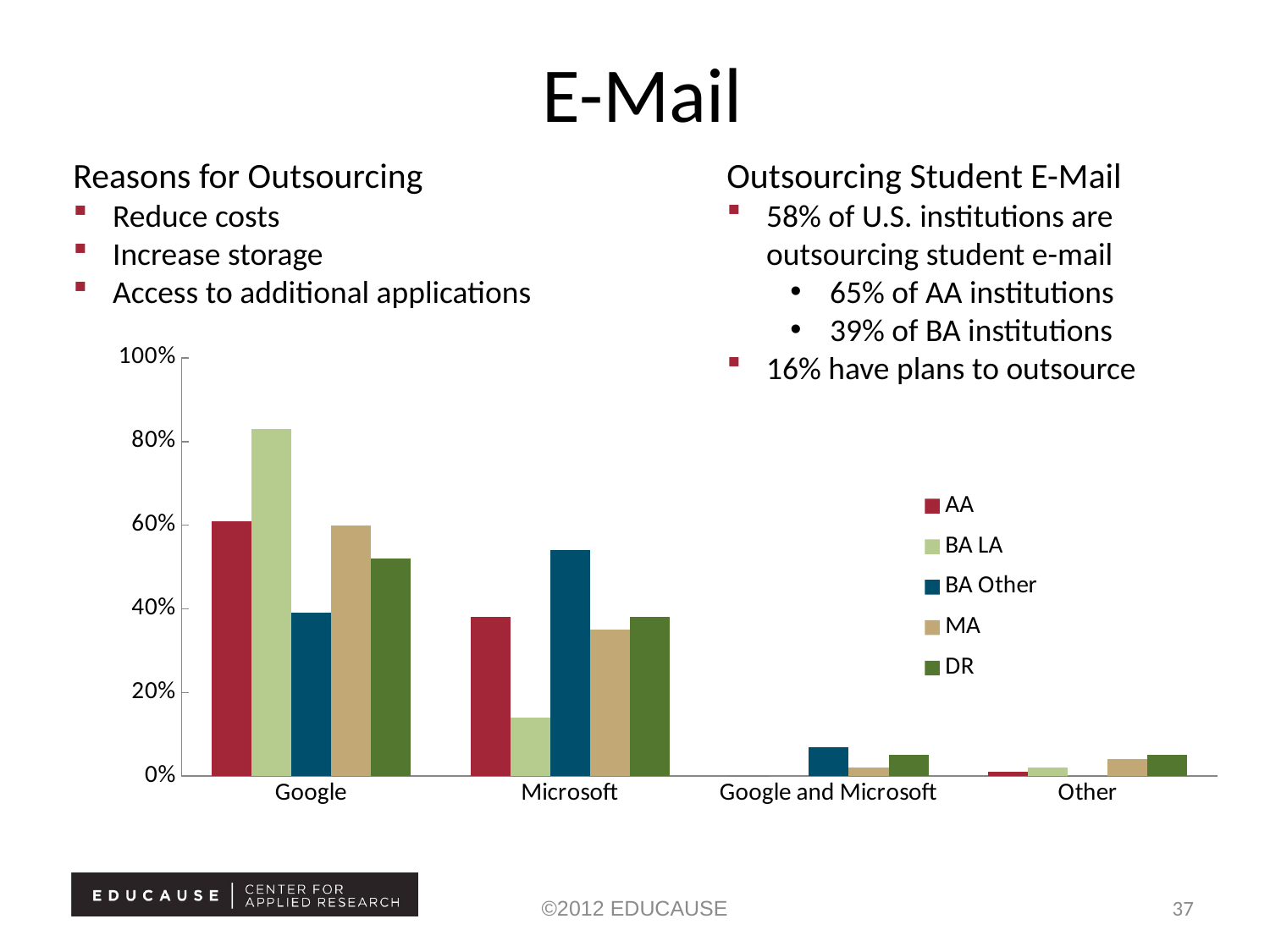
Is the BA LA value for Google greater or less than 80%? greater Which series is shown in dark green in the legend? DR Is the BA LA value for Microsoft greater or less than 20%? less Is the BA Other value for Microsoft greater or less than 40%? greater How many series does the chart's legend list? 5 What kind of chart is shown on the slide? bar chart How many categories are shown on the x axis of the chart? 4 Which series has the highest bar in the Google category? BA LA Which series has the highest bar in the Microsoft category? BA Other Which is larger: the DR value for Google or the DR value for Microsoft? Google Which series has the lowest bar in the Microsoft category? BA LA